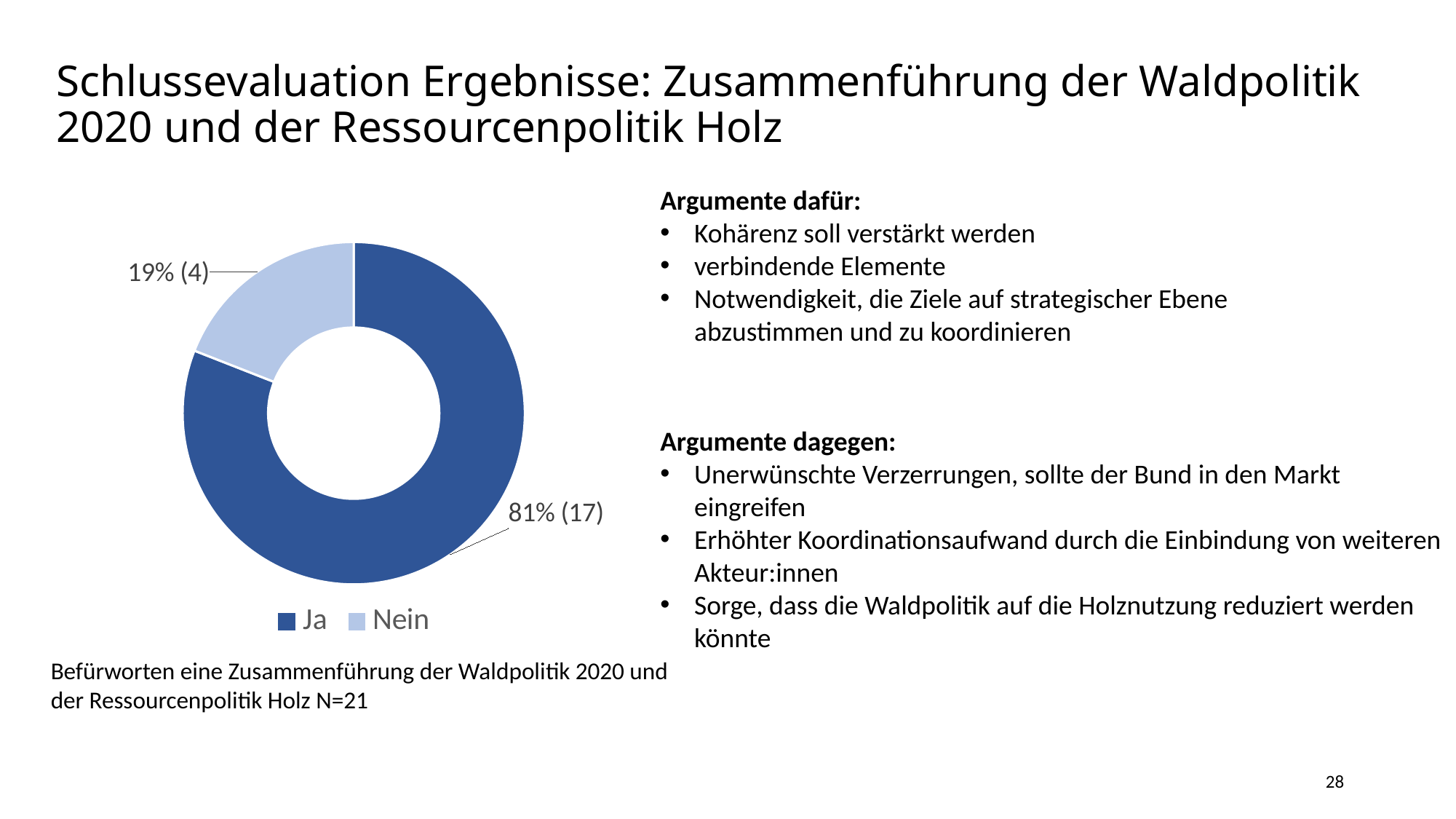
What percentage of respondents answered "Ja"? 81% What kind of chart is shown on the slide? Doughnut (pie) chart Which category has the smallest share of the chart? Nein How many respondents answered "Ja"? 17 How many more respondents answered "Ja" than "Nein"? 13 What colour is the "Nein" segment in the chart? Light blue How many respondents answered "Nein"? 4 Which category has the largest share of the chart? Ja What is the difference in percentage points between the "Ja" and "Nein" shares? 62 percentage points What percentage of respondents answered "Nein"? 19% How many categories does the chart show? 2 Which is larger, the share for "Ja" or the share for "Nein"? Ja